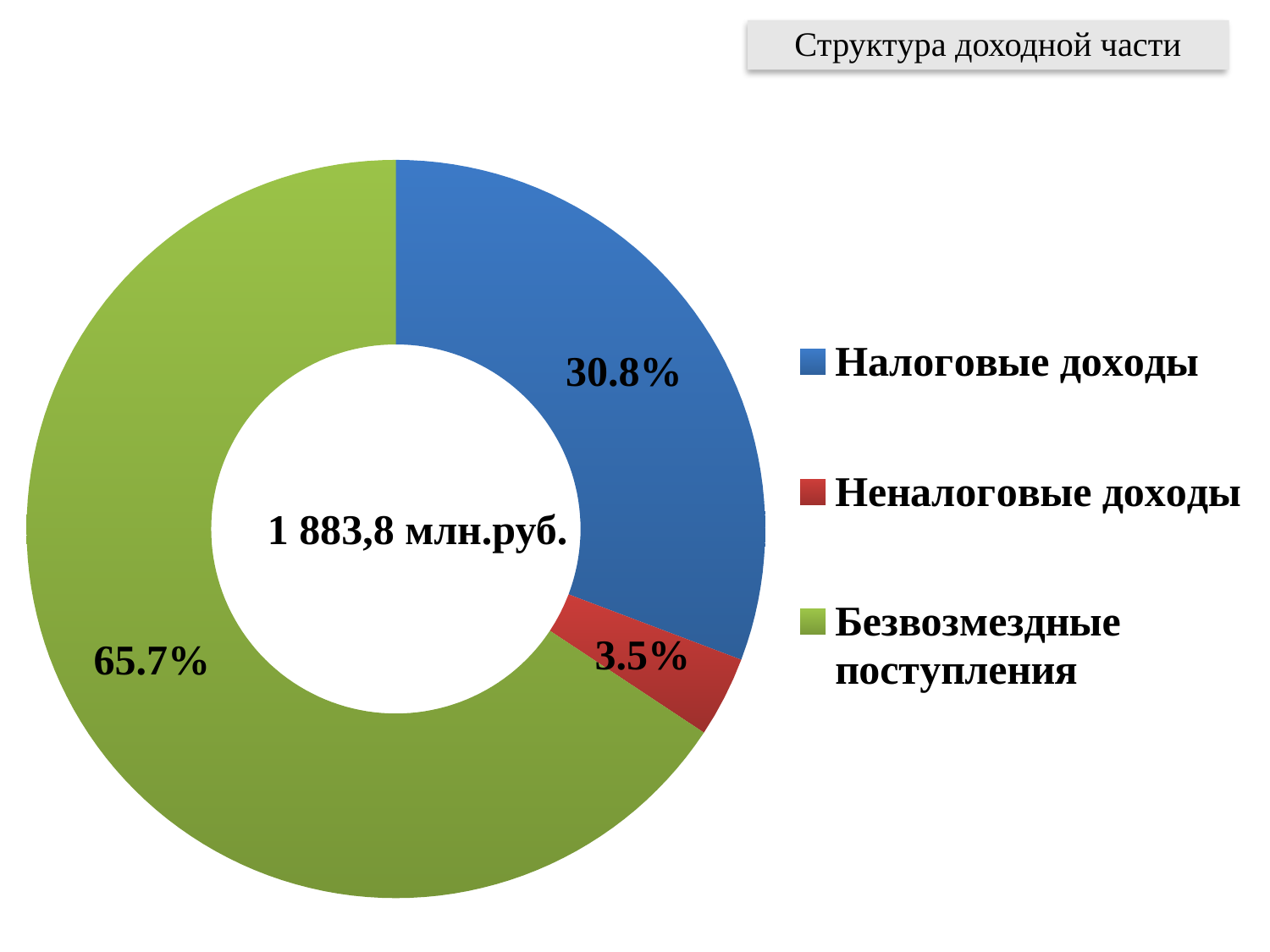
What colour is the slice for Безвозмездные поступления? Green How many categories are shown in the chart? 3 What kind of chart is shown on the slide? Doughnut chart What is the difference in percentage points between Налоговые доходы and Неналоговые доходы? 27.3 Which category has the smallest share of the chart? Неналоговые доходы What share of the chart does Налоговые доходы represent? 30.8% Which is larger, the share for Налоговые доходы or the share for Неналоговые доходы? Налоговые доходы What total amount is printed in the centre of the chart? 1 883,8 млн.руб. What share of the chart does Неналоговые доходы represent? 3.5% What share of the chart does Безвозмездные поступления represent? 65.7% What is the difference in percentage points between Безвозмездные поступления and Налоговые доходы? 34.9 Which category has the largest share of the chart? Безвозмездные поступления